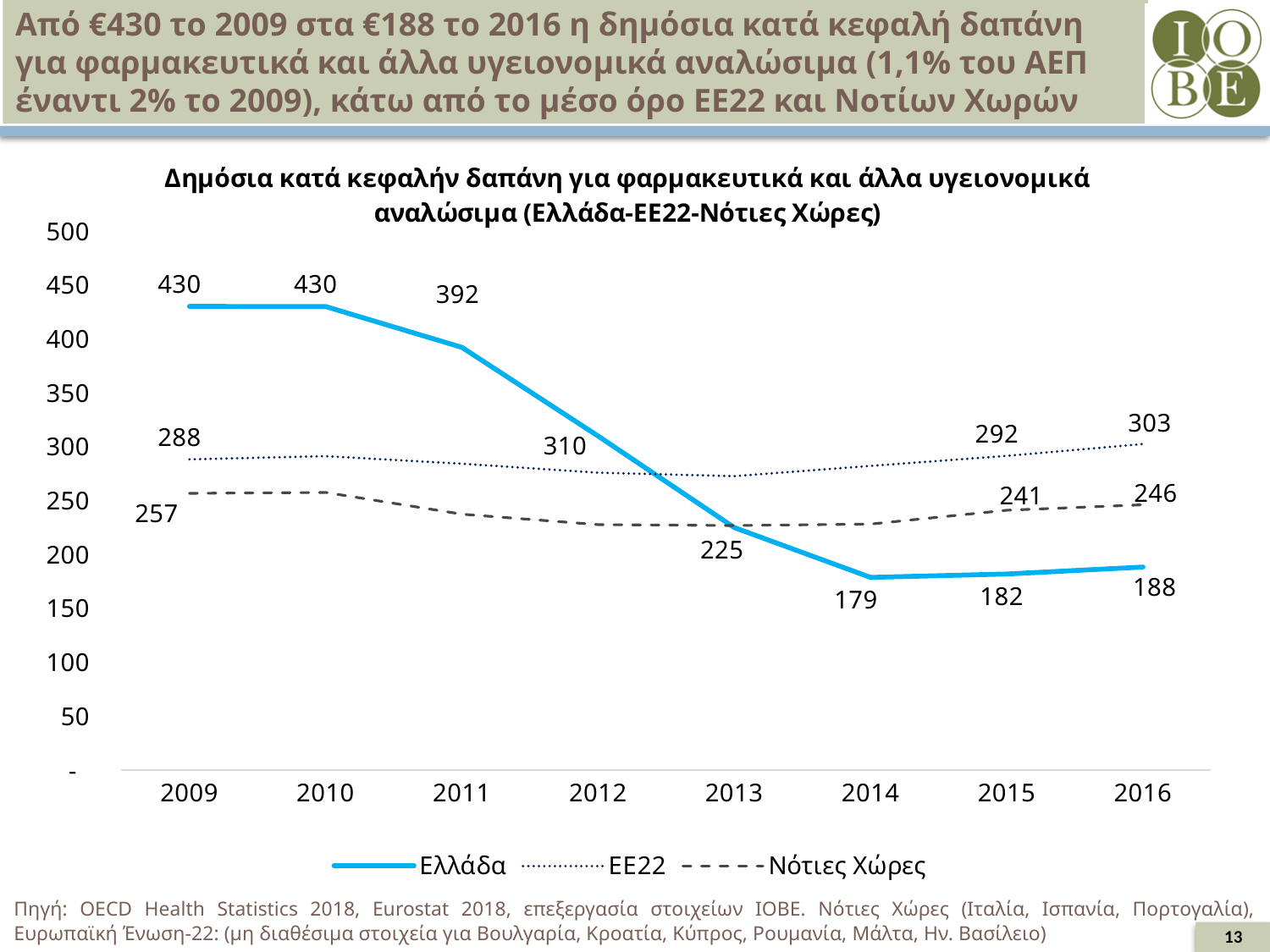
In which year is the value for Ελλάδα lowest? 2014 How many years are shown on the x axis? 8 Is the value for ΕΕ22 in 2012 greater or less than 300? less Which series has the highest value in 2016? ΕΕ22 What is the difference between the Ελλάδα values in 2009 and 2016? 242 What kind of chart is shown on the slide? line chart What is the value for ΕΕ22 in 2016? 303 Which is larger in 2016, the value for ΕΕ22 or the value for Νότιες Χώρες? ΕΕ22 How many series does the legend list? 3 What is the value for Ελλάδα in 2009? 430 What is the value for Νότιες Χώρες in 2015? 241 What is the value for Ελλάδα in 2016? 188